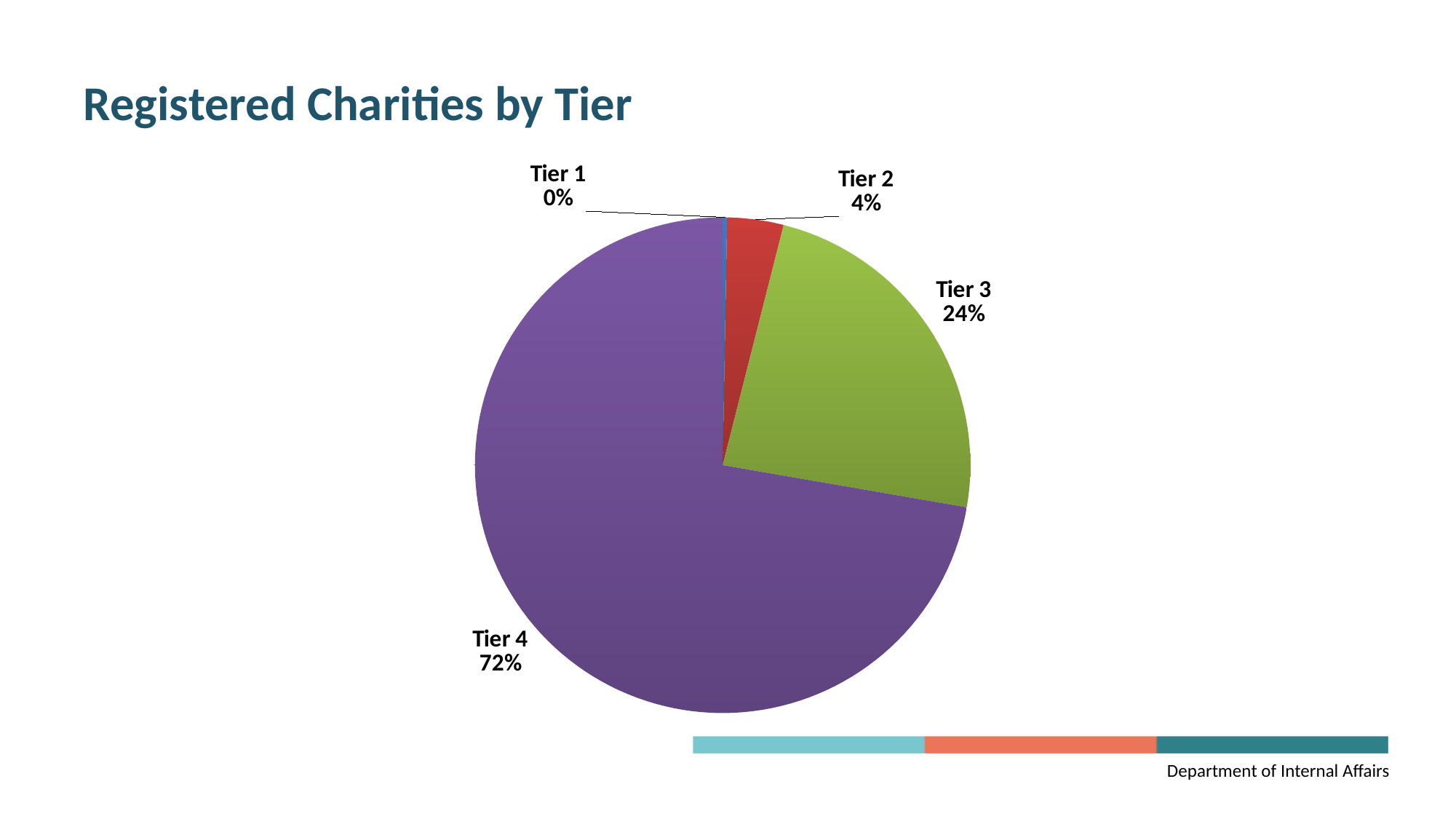
Which has a larger share, Tier 2 or Tier 3? Tier 3 What is the difference in percentage points between Tier 4 and Tier 3? 48 What is the title of the chart? Registered Charities by Tier What kind of chart is shown on the slide? pie chart What percentage of registered charities are in Tier 4? 72% Which tier has the largest share of registered charities? Tier 4 What percentage of registered charities are in Tier 3? 24% What colour is the Tier 4 slice? purple Which tier has the smallest share of registered charities? Tier 1 How many tiers are shown in the pie chart? 4 What percentage of registered charities are in Tier 2? 4% What percentage is shown for Tier 1? 0%